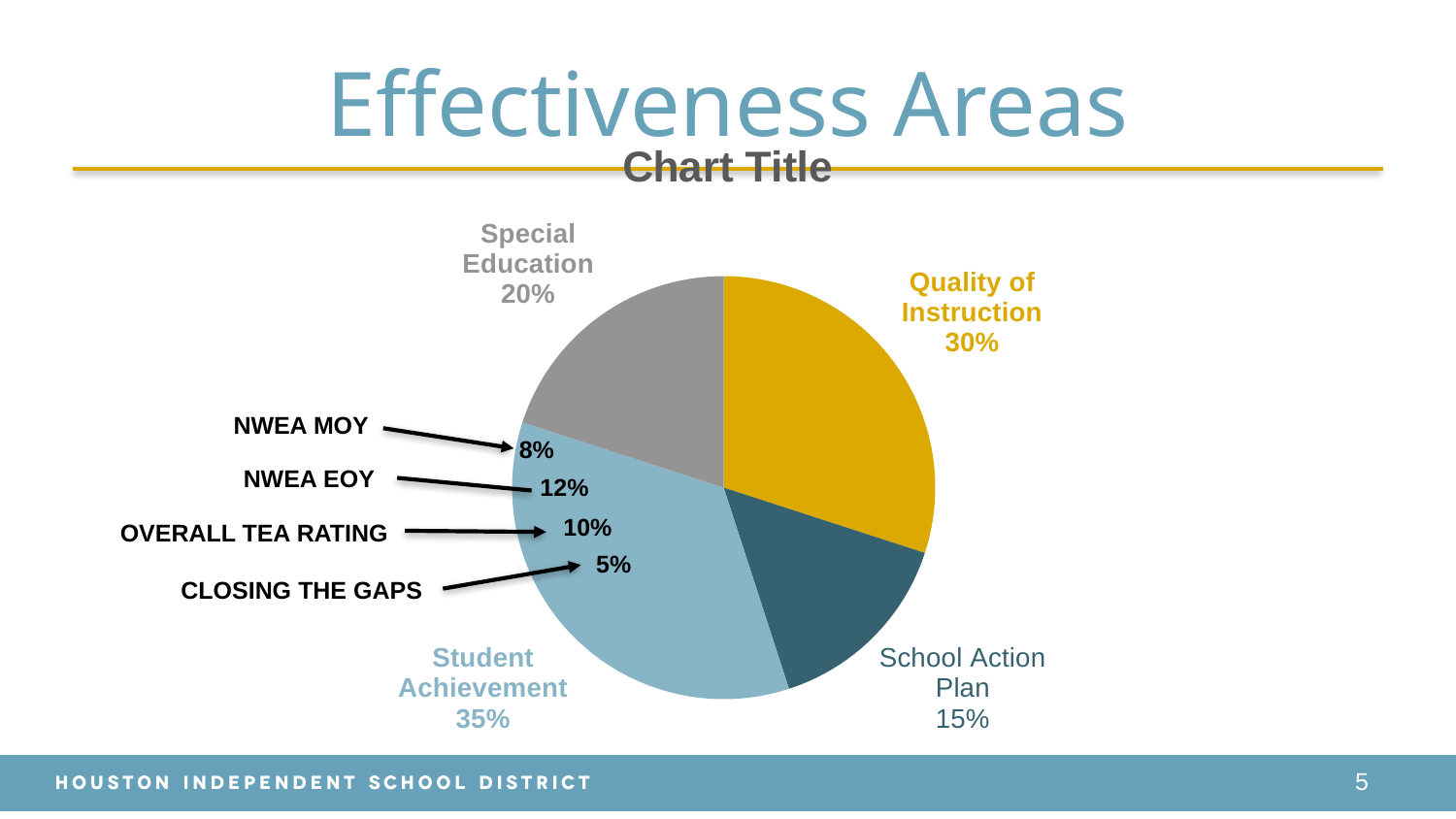
What kind of chart is shown on the slide? Pie chart Which is larger, Quality of Instruction or School Action Plan? Quality of Instruction What percentage is labelled for Closing the Gaps within the Student Achievement slice? 5% What share of the pie does Quality of Instruction represent? 30% What percentage is labelled for NWEA EOY within the Student Achievement slice? 12% Which slice of the pie is the largest? Student Achievement What is the difference between the Student Achievement share and the Special Education share? 15% How many slices does the pie chart have? 4 What share of the pie does Special Education represent? 20% What is the title printed above the pie chart? Chart Title What share of the pie does School Action Plan represent? 15% Which slice of the pie is the smallest? School Action Plan